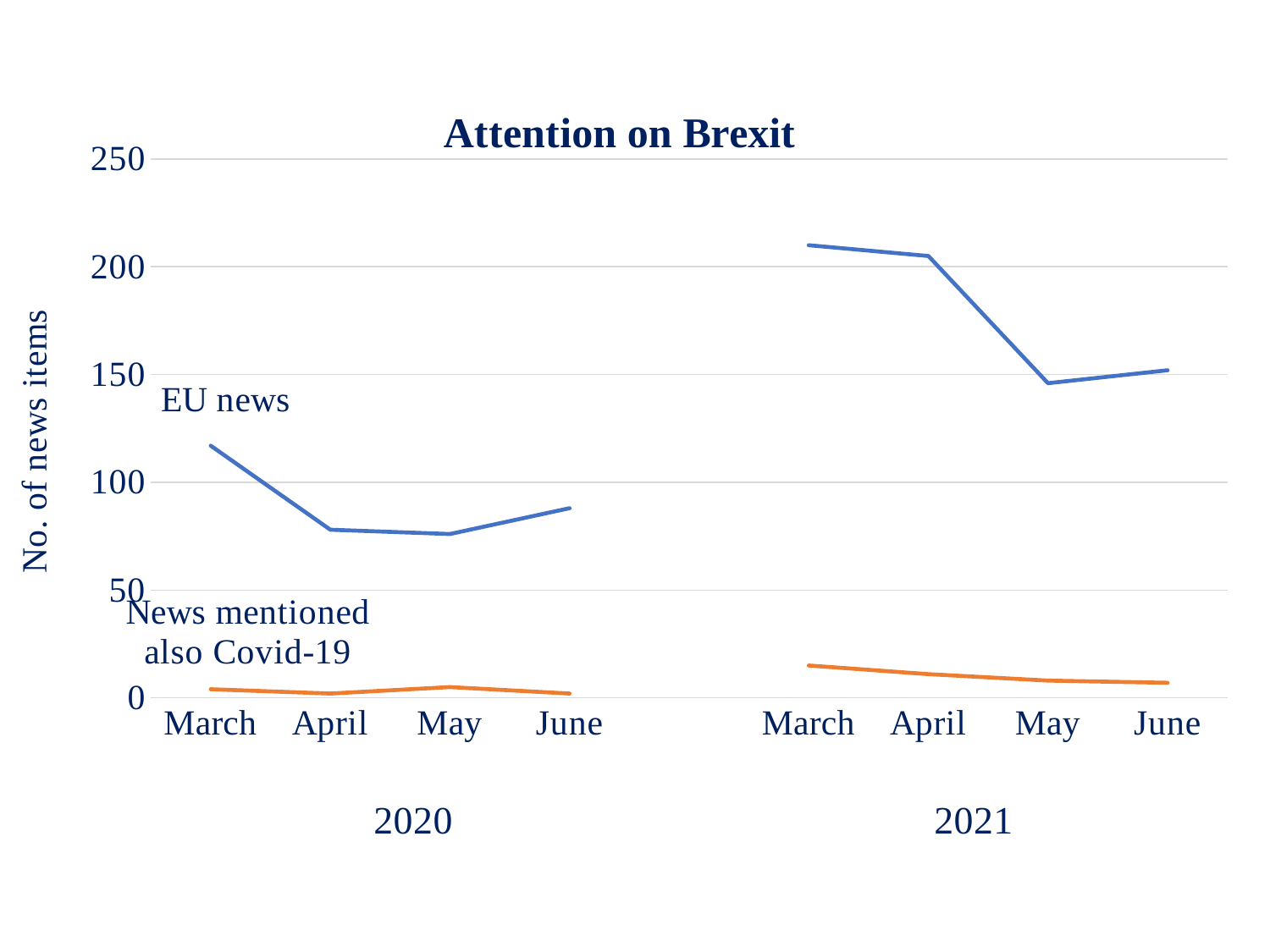
Is the value for News mentioned also Covid-19 in March 2021 greater or less than 50? less What is the label on the vertical axis of the chart? No. of news items In which month and year does the EU news line reach its highest point? March 2021 Is the value for EU news in March 2020 greater or less than 100? greater Is the value for EU news in June 2020 greater or less than 100? less What is the title of the chart? Attention on Brexit Does the EU news line rise or fall from March to May 2021? fall How many data series are plotted on the chart? 2 How many months are shown on the x axis for each year? 4 What kind of chart is shown on the slide? line chart Which is larger, the EU news value in March 2020 or in March 2021? March 2021